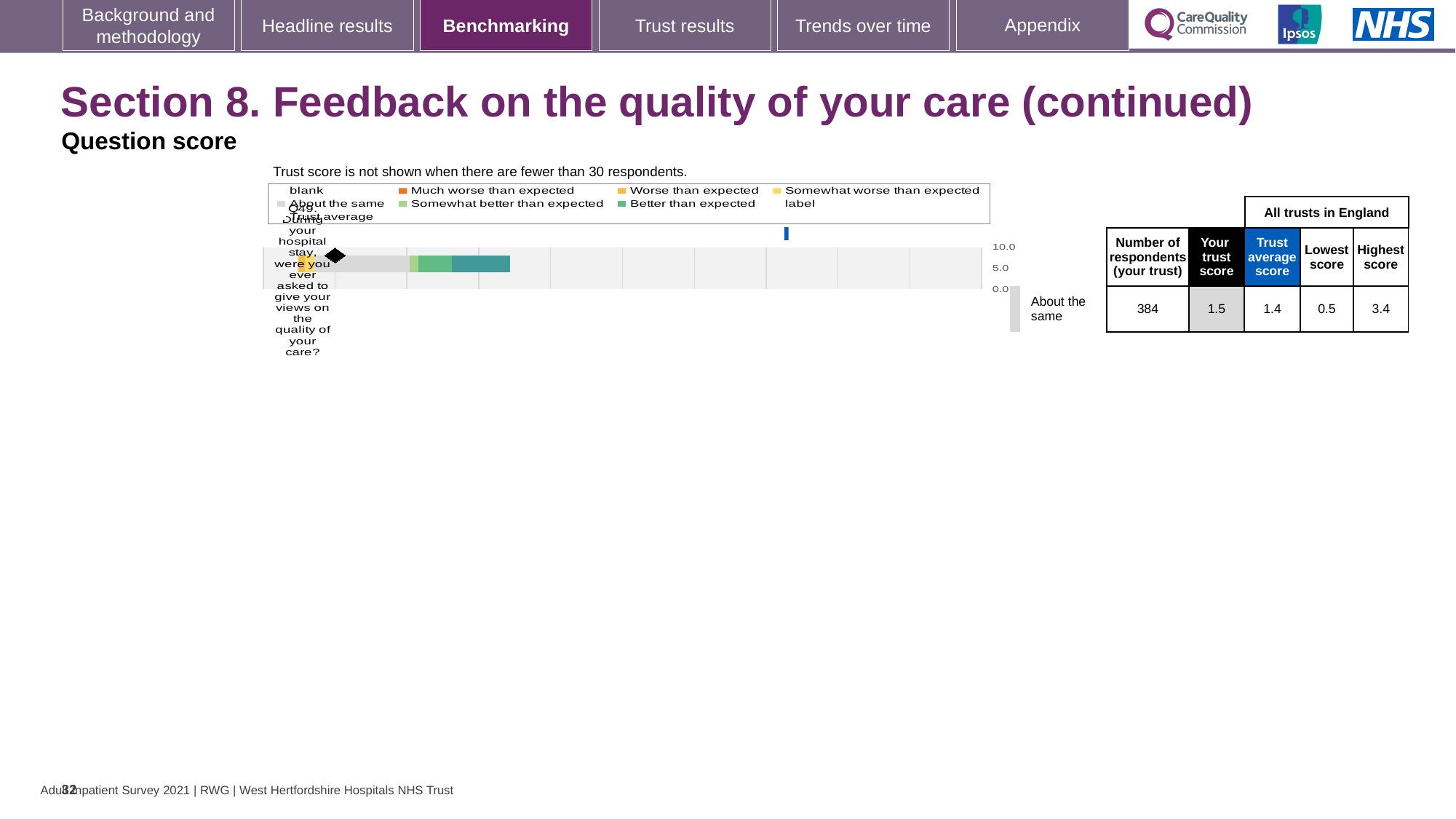
What colour does the legend use for 'Much worse than expected'? orange What is the lowest score across all trusts in England for Q49? 0.5 Which benchmark category is Q49 placed in? About the same What is the trust average score for Q49? 1.4 What kind of chart is shown on the slide? bar chart How many respondents from your trust answered Q49? 384 Which is larger for Q49, your trust score or the trust average score? your trust score What is the trust score for Q49 shown on the slide? 1.5 What is the difference between the highest score and the lowest score for Q49? 2.9 How many questions are plotted in the chart? 1 Is the trust score for Q49 greater or less than 5.0? less What is the highest score across all trusts in England for Q49? 3.4